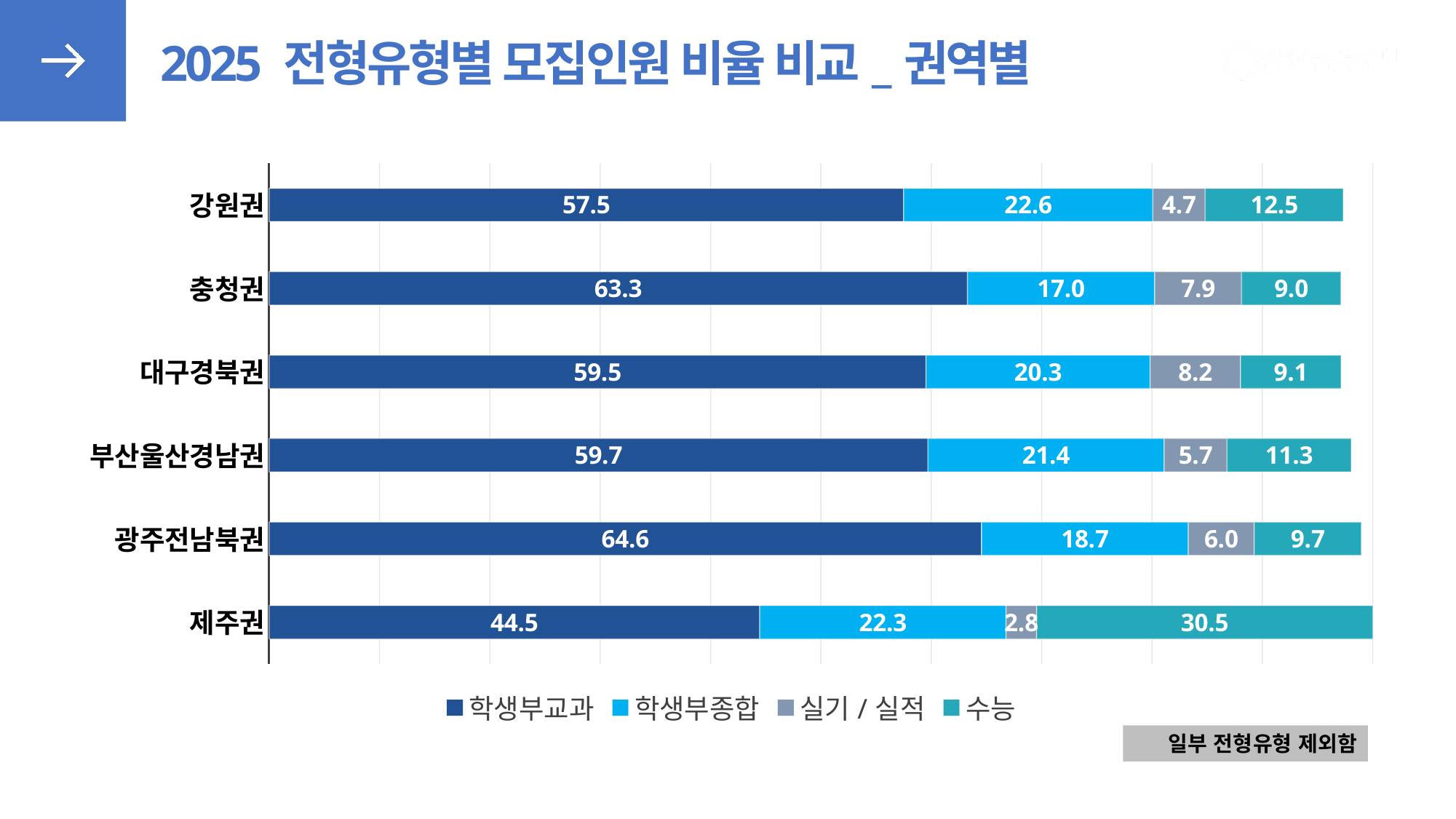
What is the 수능 value for 제주권? 30.5 How many series does the legend list? 4 What kind of chart is shown on the slide? Stacked bar chart What is the 실기 / 실적 value for 대구경북권? 8.2 Which is larger, the 수능 value for 강원권 or for 부산울산경남권? 강원권 Which region has the lowest 실기 / 실적 value? 제주권 What is the difference between the 학생부교과 values for 광주전남북권 and 제주권? 20.1 How many regions are shown on the chart? 6 What is the 학생부교과 value for 충청권? 63.3 What is the total of the stacked bar for 강원권? 97.3 What is the 학생부종합 value for 부산울산경남권? 21.4 Which region has the highest 학생부교과 value? 광주전남북권